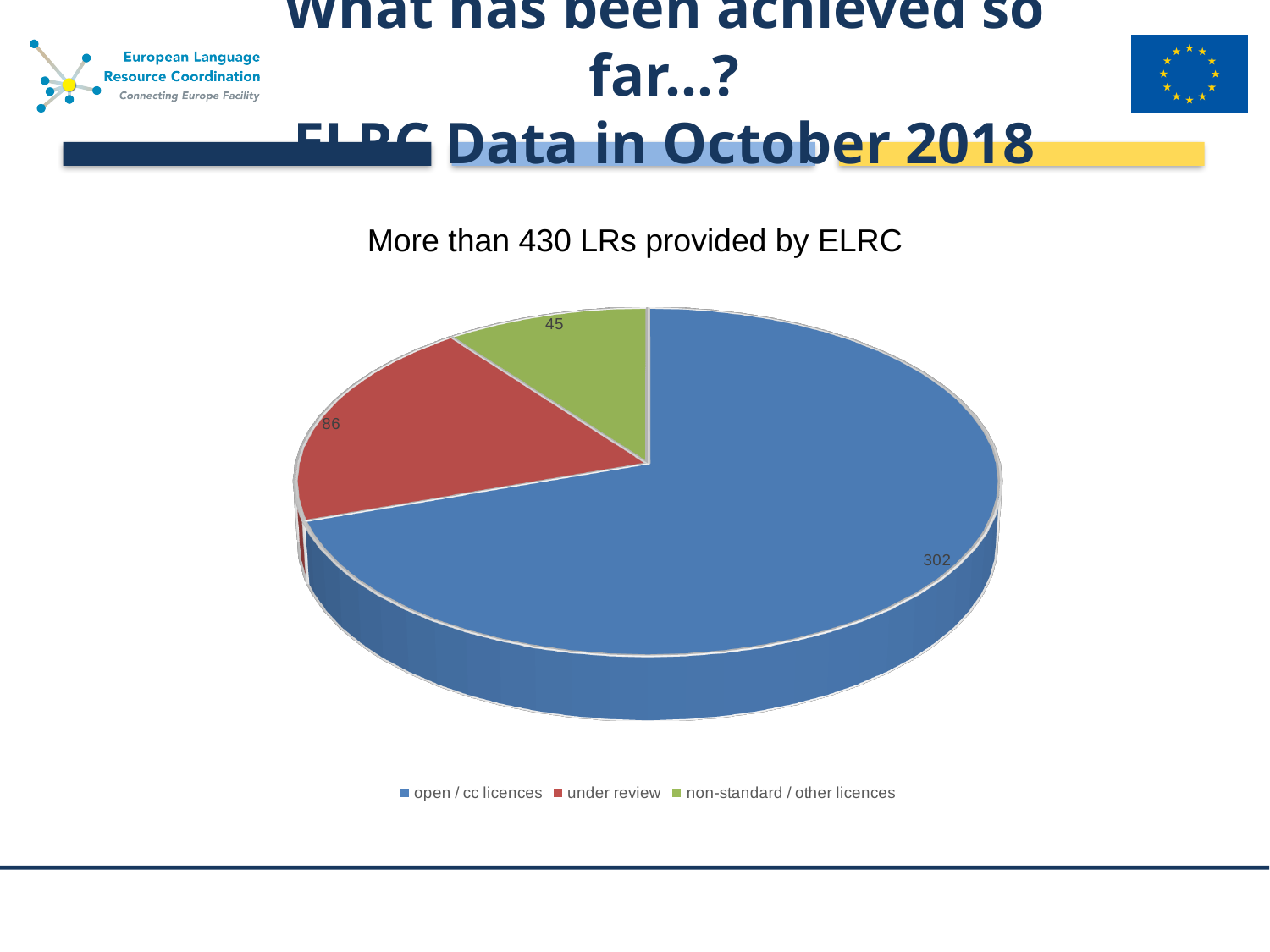
What is the value for under review? 86 What is the total of all slices in the pie chart? 433 How many categories does the pie chart show? 3 What is the difference between the values for open / cc licences and under review? 216 Which category has the smallest slice of the pie? non-standard / other licences Which is larger, the value for under review or the value for non-standard / other licences? under review Which category has the largest slice of the pie? open / cc licences What is the difference between the values for under review and non-standard / other licences? 41 What is the title shown above the pie chart? More than 430 LRs provided by ELRC What is the value for open / cc licences? 302 What kind of chart is shown on the slide? pie chart What is the value for non-standard / other licences? 45